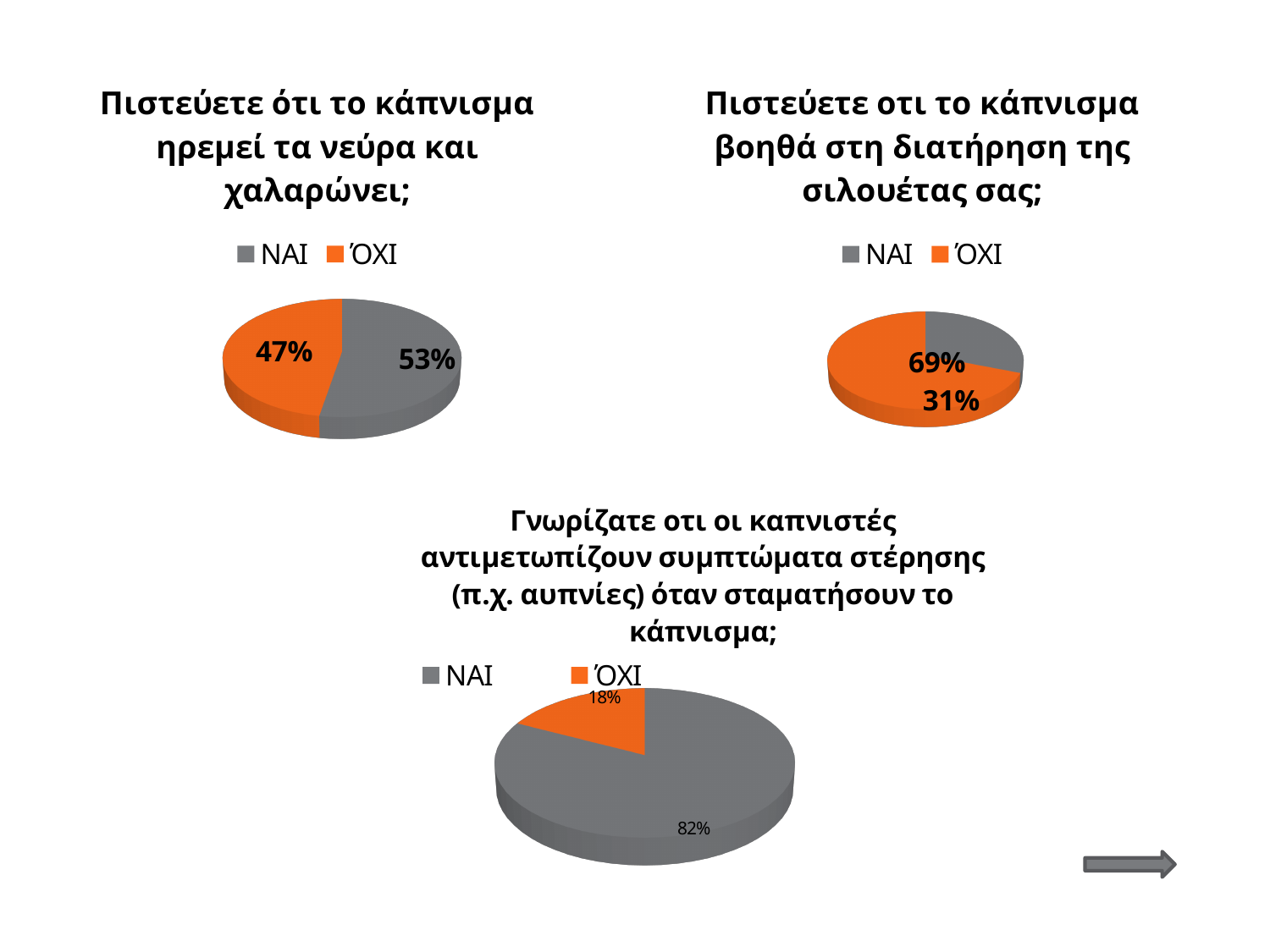
In the top-right pie chart (Πιστεύετε οτι το κάπνισμα βοηθά στη διατήρηση της σιλουέτας σας;), what percentage answered ΌΧΙ? 69% In the bottom pie chart (Γνωρίζατε οτι οι καπνιστές αντιμετωπίζουν συμπτώματα στέρησης...), what is the difference in percentage points between ΝΑΙ and ΌΧΙ? 64 percentage points What type of chart is used for the three charts on the slide? Pie chart In the top-right pie chart (Πιστεύετε οτι το κάπνισμα βοηθά στη διατήρηση της σιλουέτας σας;), which answer has the smaller share? ΝΑΙ In the top-left pie chart (Πιστεύετε ότι το κάπνισμα ηρεμεί τα νεύρα και χαλαρώνει;), what is the difference in percentage points between ΝΑΙ and ΌΧΙ? 6 percentage points In the top-left pie chart (Πιστεύετε ότι το κάπνισμα ηρεμεί τα νεύρα και χαλαρώνει;), what percentage answered ΌΧΙ? 47% In the bottom pie chart (Γνωρίζατε οτι οι καπνιστές αντιμετωπίζουν συμπτώματα στέρησης...), what percentage answered ΌΧΙ? 18% How many slices does the bottom pie chart (Γνωρίζατε οτι οι καπνιστές αντιμετωπίζουν συμπτώματα στέρησης...) have? 2 In the top-left pie chart (Πιστεύετε ότι το κάπνισμα ηρεμεί τα νεύρα και χαλαρώνει;), which answer has the larger share? ΝΑΙ In the bottom pie chart (Γνωρίζατε οτι οι καπνιστές αντιμετωπίζουν συμπτώματα στέρησης...), what percentage answered ΝΑΙ? 82% In the top-right pie chart (Πιστεύετε οτι το κάπνισμα βοηθά στη διατήρηση της σιλουέτας σας;), what percentage answered ΝΑΙ? 31% In the top-left pie chart (Πιστεύετε ότι το κάπνισμα ηρεμεί τα νεύρα και χαλαρώνει;), what percentage answered ΝΑΙ? 53%